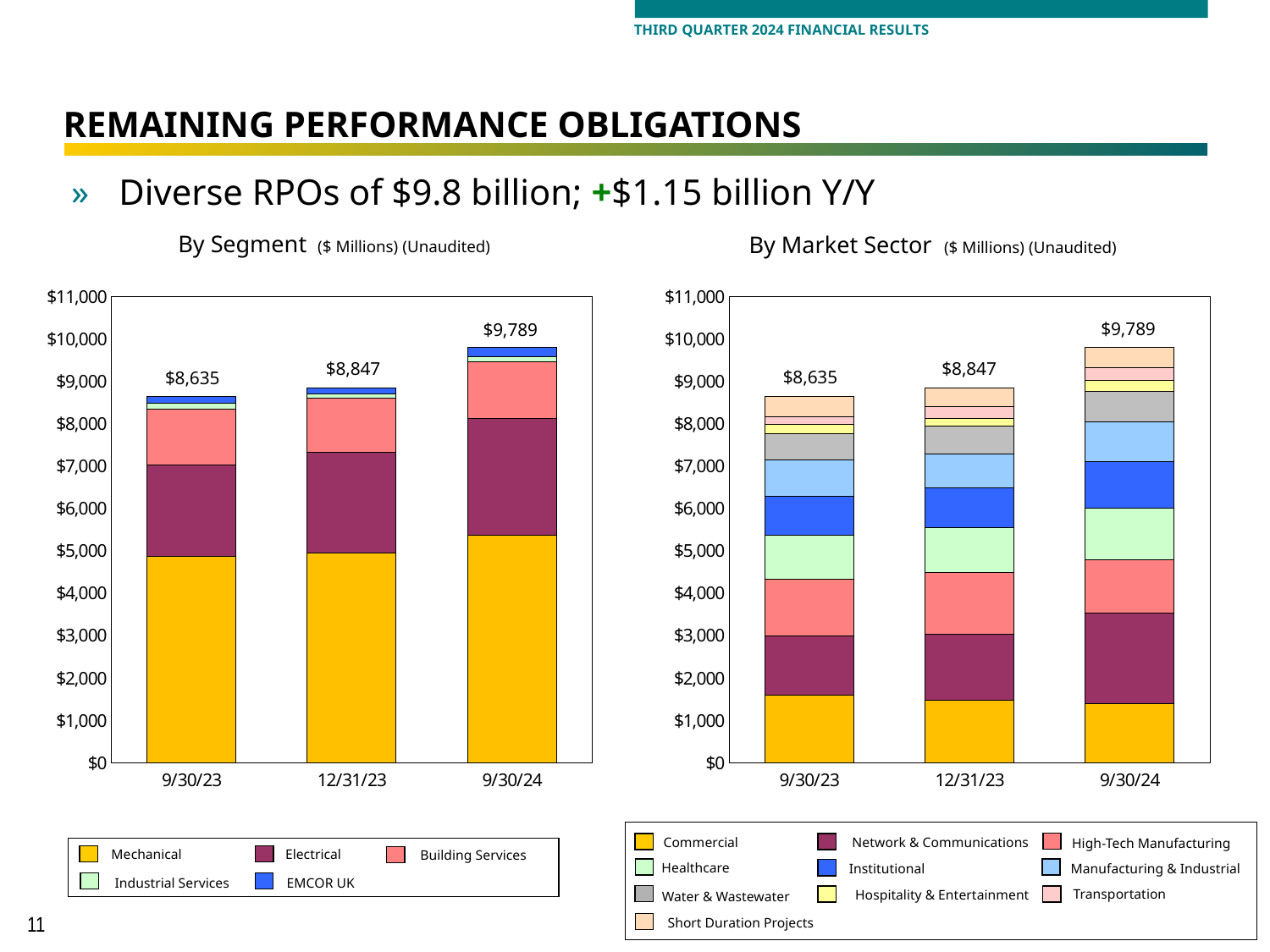
In the By Market Sector chart, what is the difference between the 12/31/23 total and the 9/30/23 total? $212 In the By Segment chart, what is the total remaining performance obligations shown for 9/30/24? $9,789 In the By Segment chart, which date has the highest total? 9/30/24 In the By Segment chart, is the Mechanical value for 9/30/24 greater or less than $5,000? greater In the By Market Sector chart, what is the total shown for 9/30/23? $8,635 In the By Segment chart, what is the difference between the 9/30/24 total and the 9/30/23 total? $1,154 In the By Market Sector chart, is the Commercial value for 9/30/24 greater or less than $2,000? less How many series does the legend of the By Market Sector chart list? 10 In the By Market Sector chart, which date has the lowest total? 9/30/23 How many series does the legend of the By Segment chart list? 5 In the By Segment chart, do the totals rise or fall from 9/30/23 to 9/30/24? rise In the By Segment chart, what is the total shown for 12/31/23? $8,847